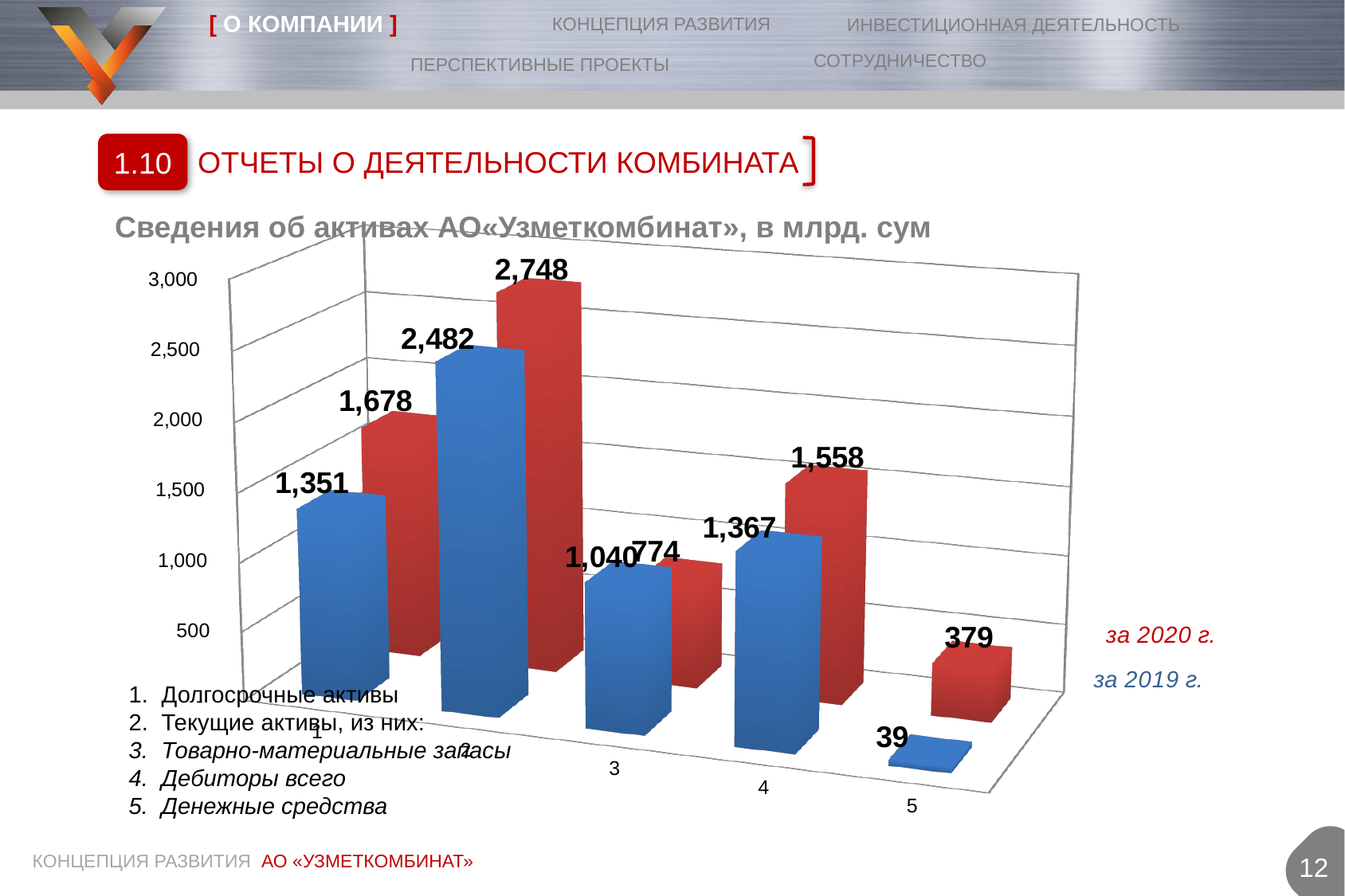
Which category has the lowest value for 2019 (за 2019 г.)? Денежные средства (category 5) How many series does the chart show? 2 What is the value for Дебиторы всего (category 4) for 2019 (за 2019 г.)? 1,367 What kind of chart is shown on the slide? Bar chart What is the value for Денежные средства (category 5) for 2020 (за 2020 г.)? 379 What is the value for Долгосрочные активы (category 1) for 2020 (за 2020 г.)? 1,678 What is the value for Текущие активы (category 2) for 2019 (за 2019 г.)? 2,482 What colour are the bars for 2020 (за 2020 г.)? Red How many categories are shown on the x axis? 5 Which category has the highest value for 2020 (за 2020 г.)? Текущие активы (category 2) Which is larger for Товарно-материальные запасы (category 3): the 2019 value or the 2020 value? 2019 (1,040) What is the difference between the 2020 and 2019 values for Текущие активы (category 2)? 266